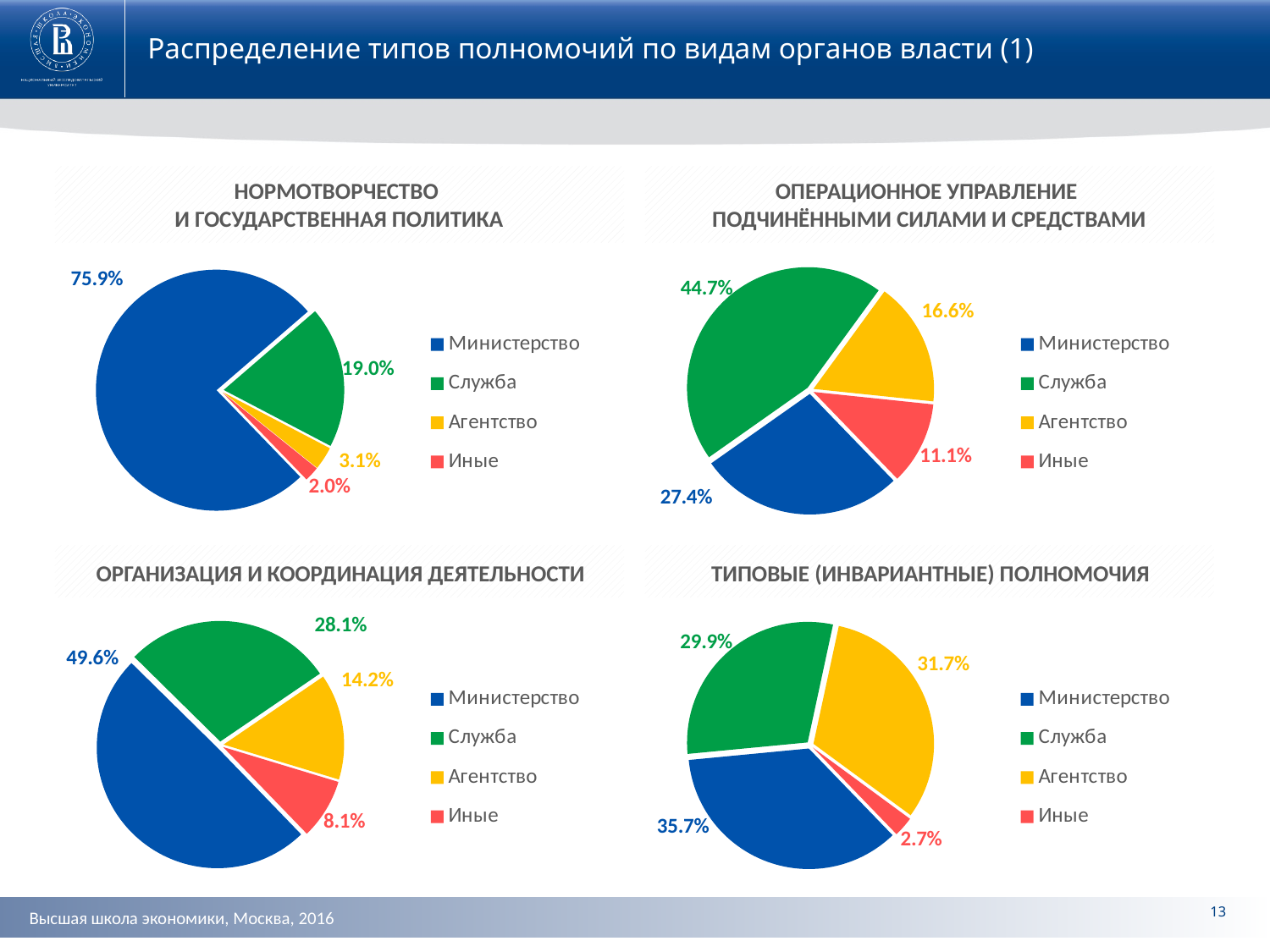
In the chart titled «ТИПОВЫЕ (ИНВАРИАНТНЫЕ) ПОЛНОМОЧИЯ», what is the difference between the shares of Агентство and Служба? 1.8% In the chart titled «ОПЕРАЦИОННОЕ УПРАВЛЕНИЕ ПОДЧИНЁННЫМИ СИЛАМИ И СРЕДСТВАМИ», what share does Агентство have? 16.6% What type of chart is the chart titled «НОРМОТВОРЧЕСТВО И ГОСУДАРСТВЕННАЯ ПОЛИТИКА»? Pie chart In the chart titled «ТИПОВЫЕ (ИНВАРИАНТНЫЕ) ПОЛНОМОЧИЯ», which category has the smallest share? Иные In the chart titled «ОПЕРАЦИОННОЕ УПРАВЛЕНИЕ ПОДЧИНЁННЫМИ СИЛАМИ И СРЕДСТВАМИ», which category has the largest share? Служба In the chart titled «ОРГАНИЗАЦИЯ И КООРДИНАЦИЯ ДЕЯТЕЛЬНОСТИ», what share does Иные have? 8.1% In the chart titled «ОРГАНИЗАЦИЯ И КООРДИНАЦИЯ ДЕЯТЕЛЬНОСТИ», which is larger, the share of Служба or the share of Агентство? Служба How many categories does the legend of the chart titled «ОРГАНИЗАЦИЯ И КООРДИНАЦИЯ ДЕЯТЕЛЬНОСТИ» list? 4 In the chart titled «ОПЕРАЦИОННОЕ УПРАВЛЕНИЕ ПОДЧИНЁННЫМИ СИЛАМИ И СРЕДСТВАМИ», what is the difference between the shares of Служба and Министерство? 17.3% In the chart titled «ТИПОВЫЕ (ИНВАРИАНТНЫЕ) ПОЛНОМОЧИЯ», what share does Министерство have? 35.7% In the chart titled «НОРМОТВОРЧЕСТВО И ГОСУДАРСТВЕННАЯ ПОЛИТИКА», which category has the smallest share? Иные In the chart titled «НОРМОТВОРЧЕСТВО И ГОСУДАРСТВЕННАЯ ПОЛИТИКА», what share does Министерство have? 75.9%